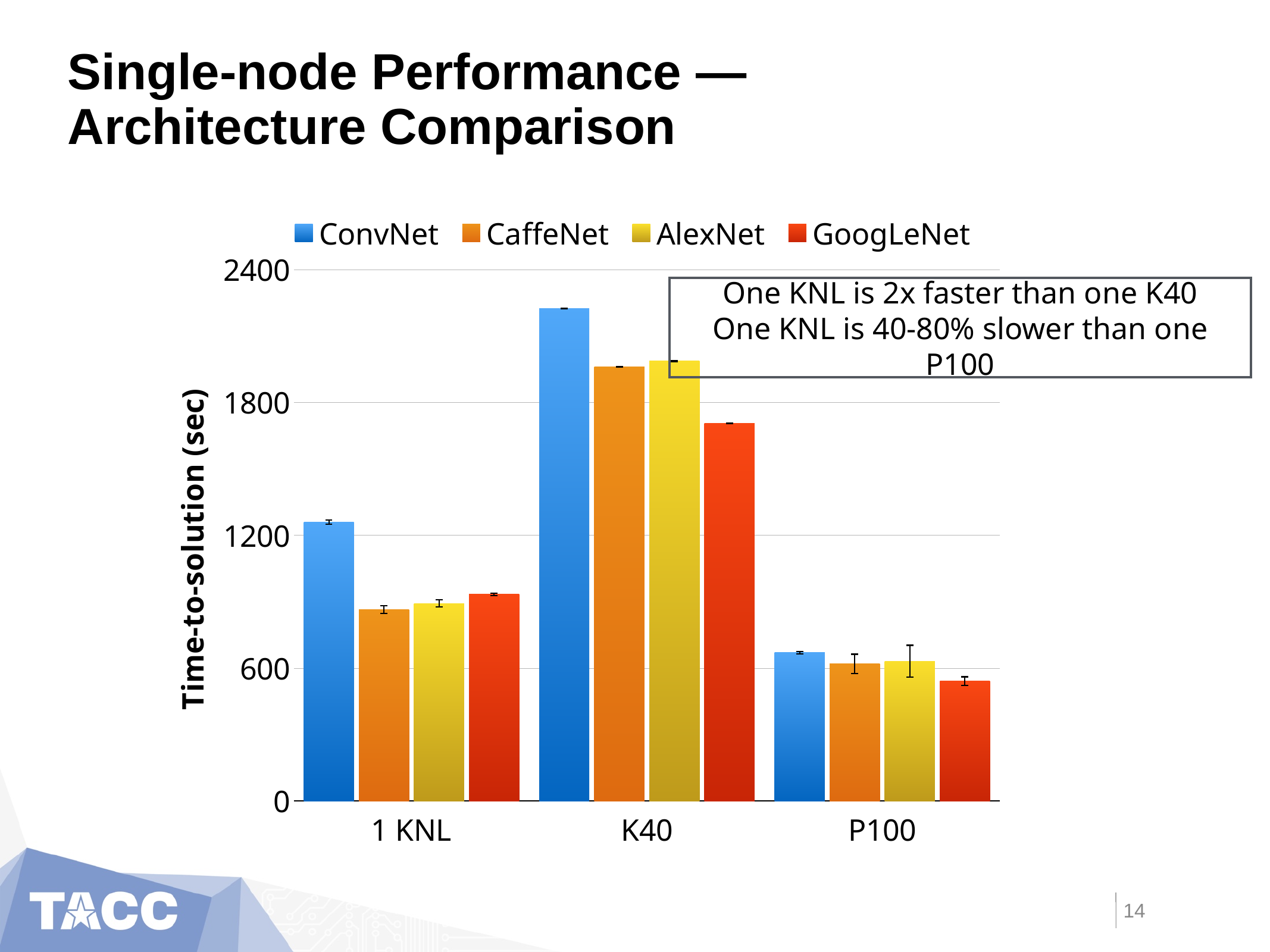
What kind of chart is shown on the slide? bar chart How many architecture categories are shown on the x axis? 3 Is the ConvNet value for K40 greater or less than 1800? greater Which architecture has the lowest GoogLeNet time-to-solution? P100 For K40, which is larger: the ConvNet value or the GoogLeNet value? ConvNet Is the GoogLeNet value for P100 greater or less than 600? less Is the GoogLeNet value for K40 greater or less than 1800? less What is the label of the y axis? Time-to-solution (sec) How many series does the legend list? 4 Which architecture has the highest ConvNet time-to-solution? K40